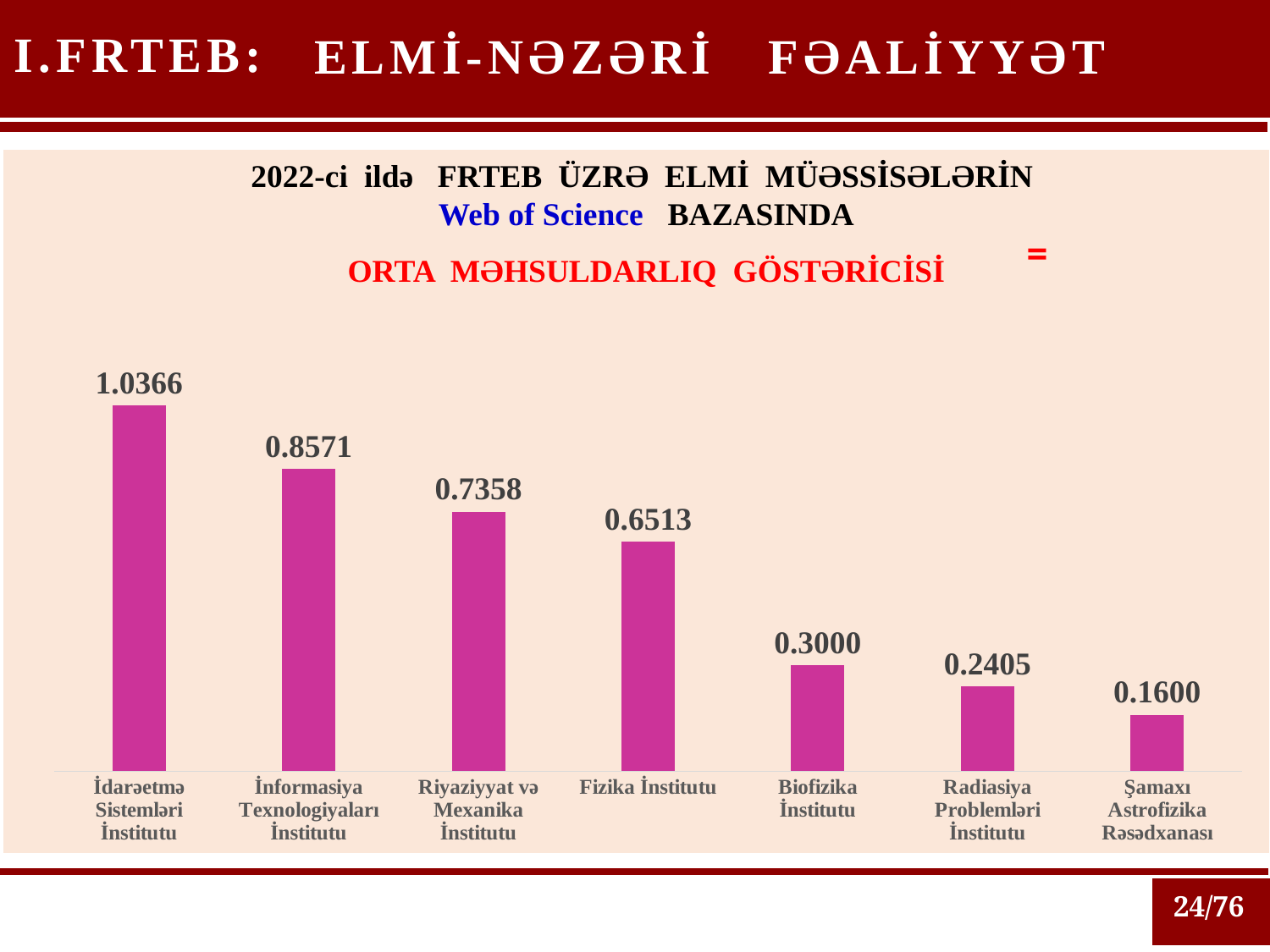
Do the values rise or fall from left to right across the chart? Fall Which institution has the highest value? İdarəetmə Sistemləri İnstitutu What is the difference between the values for İdarəetmə Sistemləri İnstitutu and İnformasiya Texnologiyaları İnstitutu? 0.1795 What is the difference between the values for Biofizika İnstitutu and Şamaxı Astrofizika Rəsədxanası? 0.1400 What is the value for Şamaxı Astrofizika Rəsədxanası? 0.1600 Which is larger, the value for Radiasiya Problemləri İnstitutu or the value for Biofizika İnstitutu? Biofizika İnstitutu What is the value for Fizika İnstitutu? 0.6513 What kind of chart is shown on the slide? Bar chart What is the value for Biofizika İnstitutu? 0.3000 What is the value for Riyaziyyat və Mexanika İnstitutu? 0.7358 How many institutions are shown in the chart? 7 Which institution has the lowest value? Şamaxı Astrofizika Rəsədxanası